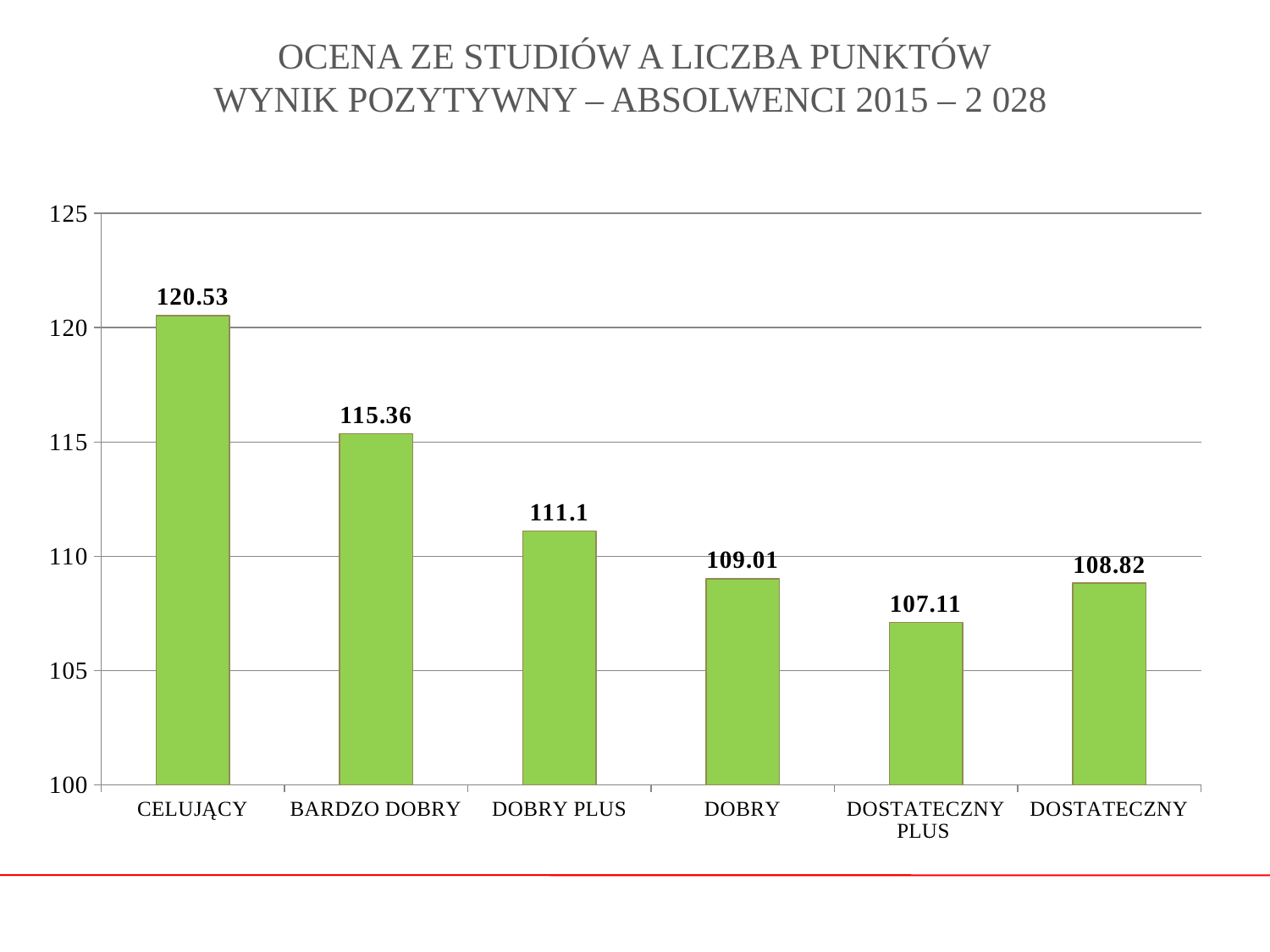
Is the value for BARDZO DOBRY greater or less than 115? greater Which is larger, the value for BARDZO DOBRY or the value for DOBRY PLUS? BARDZO DOBRY What is the value for CELUJĄCY? 120.53 How many categories are shown on the x axis? 6 What is the difference between the values for CELUJĄCY and BARDZO DOBRY? 5.17 What colour are the bars in the chart? green What is the difference between the values for DOBRY and DOSTATECZNY? 0.19 What is the value for DOBRY PLUS? 111.1 Which category has the highest value? CELUJĄCY Which category has the lowest value? DOSTATECZNY PLUS What is the value for DOSTATECZNY PLUS? 107.11 What kind of chart is shown on the slide? bar chart